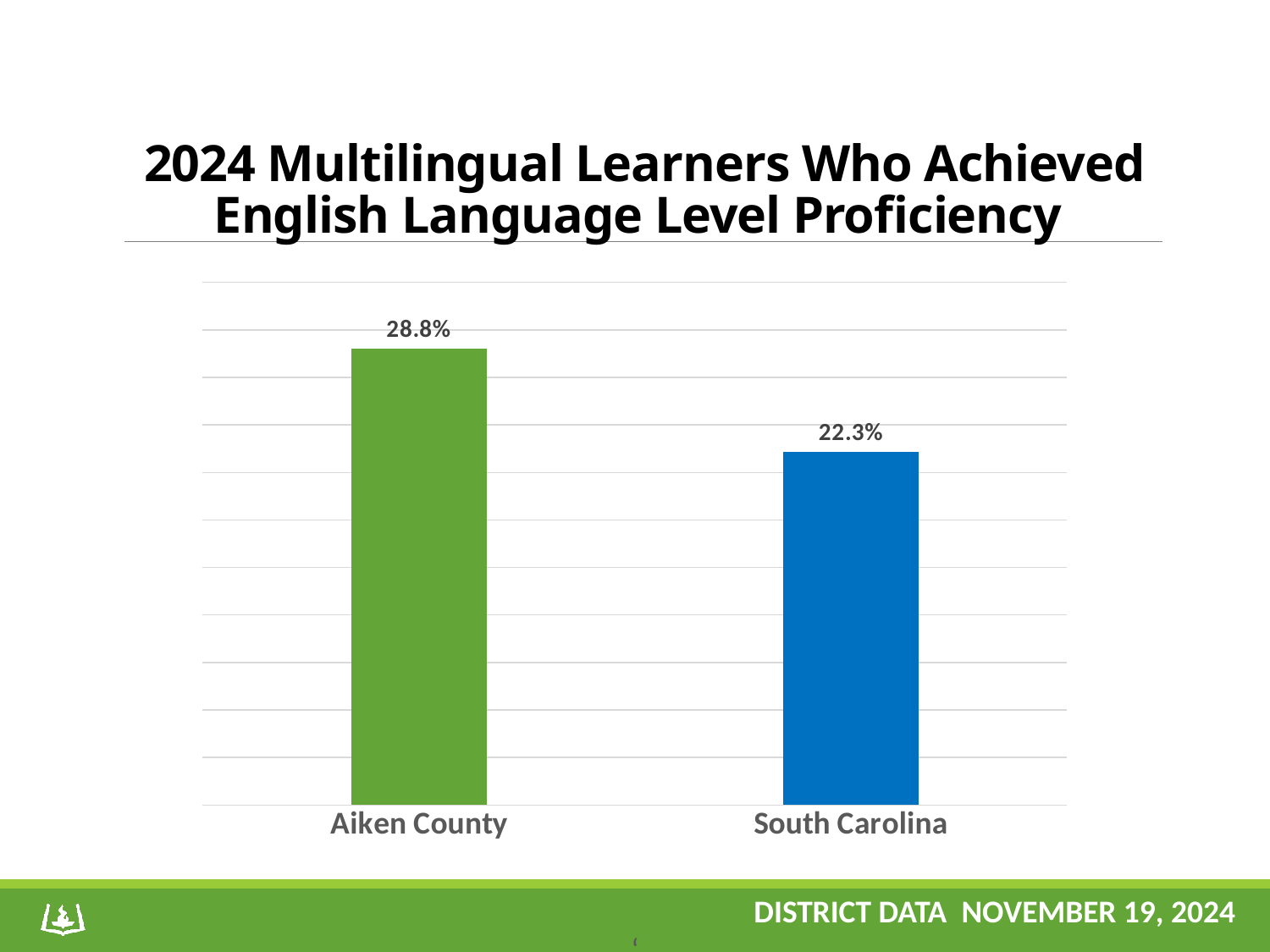
How many categories are shown in the chart? 2 Is the value for Aiken County larger or smaller than the value for South Carolina? larger What percentage of multilingual learners in Aiken County achieved English language level proficiency in 2024? 28.8% What is the difference in percentage points between Aiken County and South Carolina? 6.5 Which category has the lower percentage of multilingual learners achieving proficiency? South Carolina What percentage of multilingual learners in South Carolina achieved English language level proficiency in 2024? 22.3% Which category has the higher percentage of multilingual learners achieving proficiency? Aiken County What type of chart is shown on the slide? bar chart What is the title of the chart? 2024 Multilingual Learners Who Achieved English Language Level Proficiency What colour is the bar for Aiken County? green